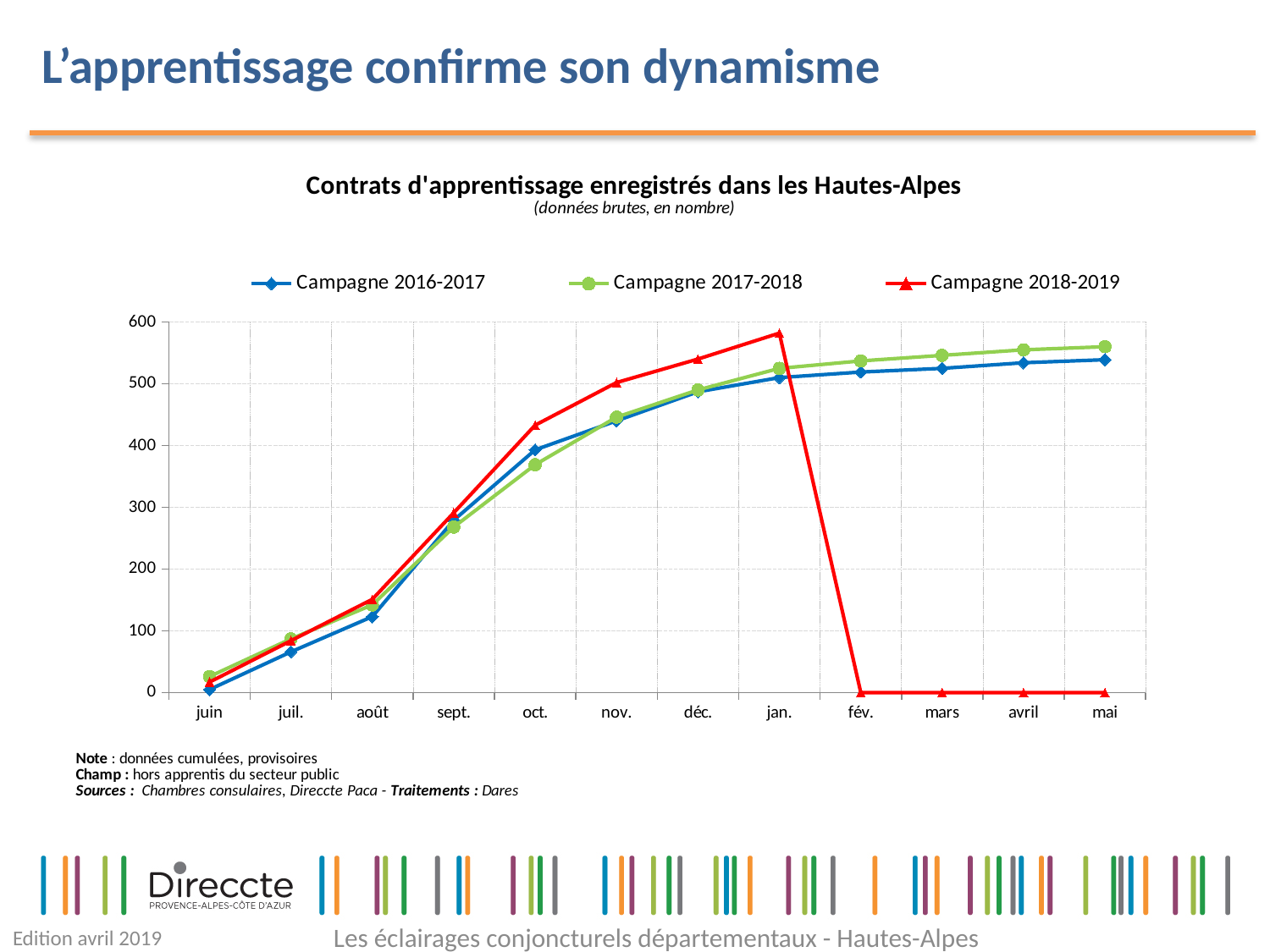
Is the value for Campagne 2018-2019 in jan. greater or less than 500? greater Is the value for Campagne 2016-2017 in juin greater or less than 100? less Which series is drawn in red with triangle markers? Campagne 2018-2019 In jan., which series has the larger value, Campagne 2018-2019 or Campagne 2016-2017? Campagne 2018-2019 Do the values for Campagne 2016-2017 rise or fall from juin to mai? rise What kind of chart is shown on the slide? line chart In oct., which series has the larger value, Campagne 2018-2019 or Campagne 2017-2018? Campagne 2018-2019 How many series does the legend list? 3 What is the title of the chart? Contrats d'apprentissage enregistrés dans les Hautes-Alpes How many months are shown along the x axis? 12 Is the value for Campagne 2018-2019 in oct. greater or less than 400? greater